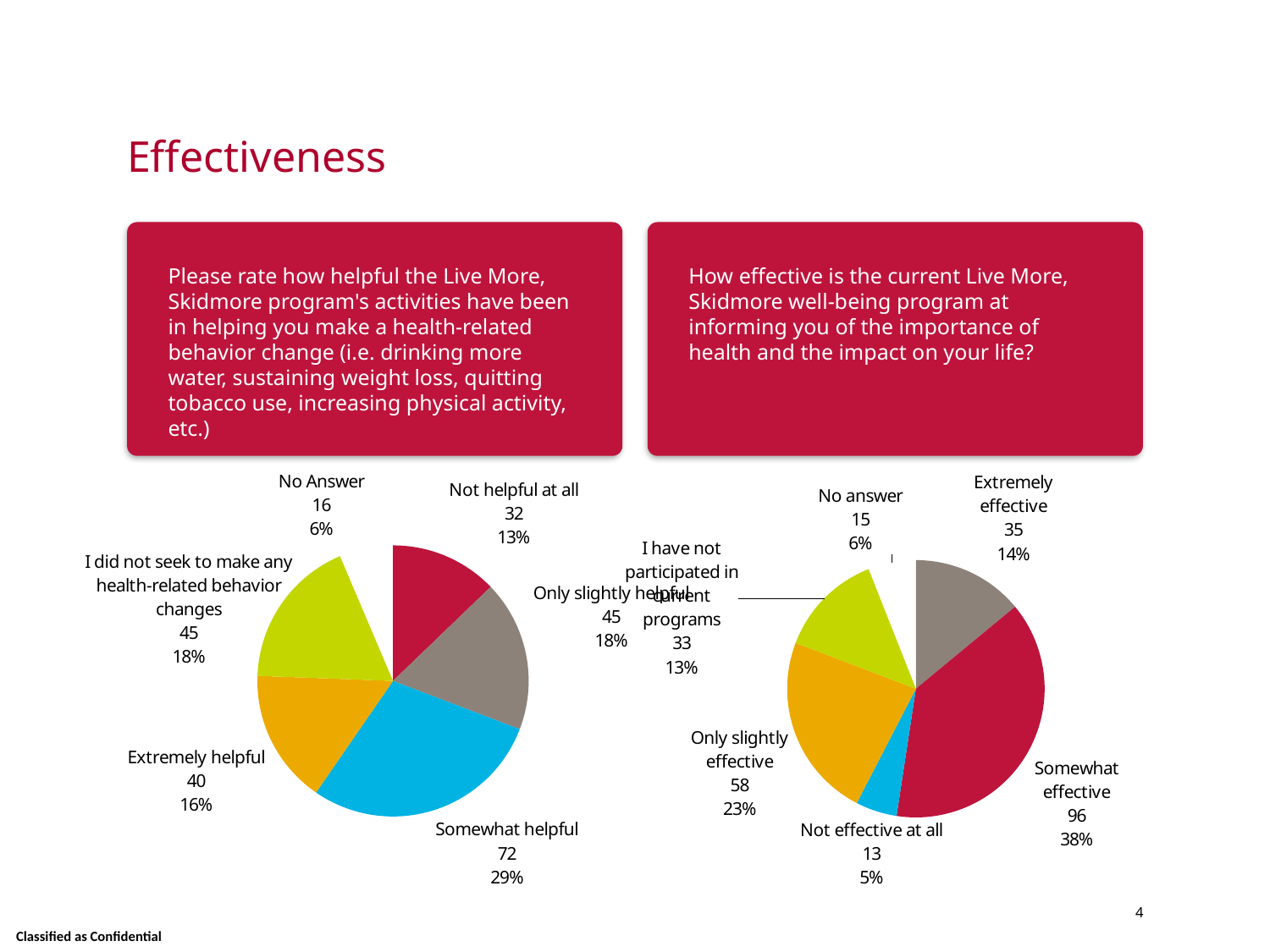
On the right pie chart, which category has the smallest slice? Not effective at all On the left pie chart, which category has the largest slice? Somewhat helpful On the right pie chart, what is the difference in count between "Somewhat effective" and "Extremely effective"? 61 On the left pie chart, which category has the smallest slice? No Answer On the left pie chart, how many respondents chose "Somewhat helpful"? 72 What type of chart is used on the right side of the slide? Pie chart On the right pie chart, how many respondents chose "Somewhat effective"? 96 On the left pie chart, what is the difference in count between "Somewhat helpful" and "Not helpful at all"? 40 On the left pie chart, what percentage share does "Extremely helpful" have? 16% On the right pie chart, what percentage share does "Only slightly effective" have? 23% On the right pie chart, which is larger: "Extremely effective" or "Only slightly effective"? Only slightly effective How many categories are shown on the left pie chart? 6